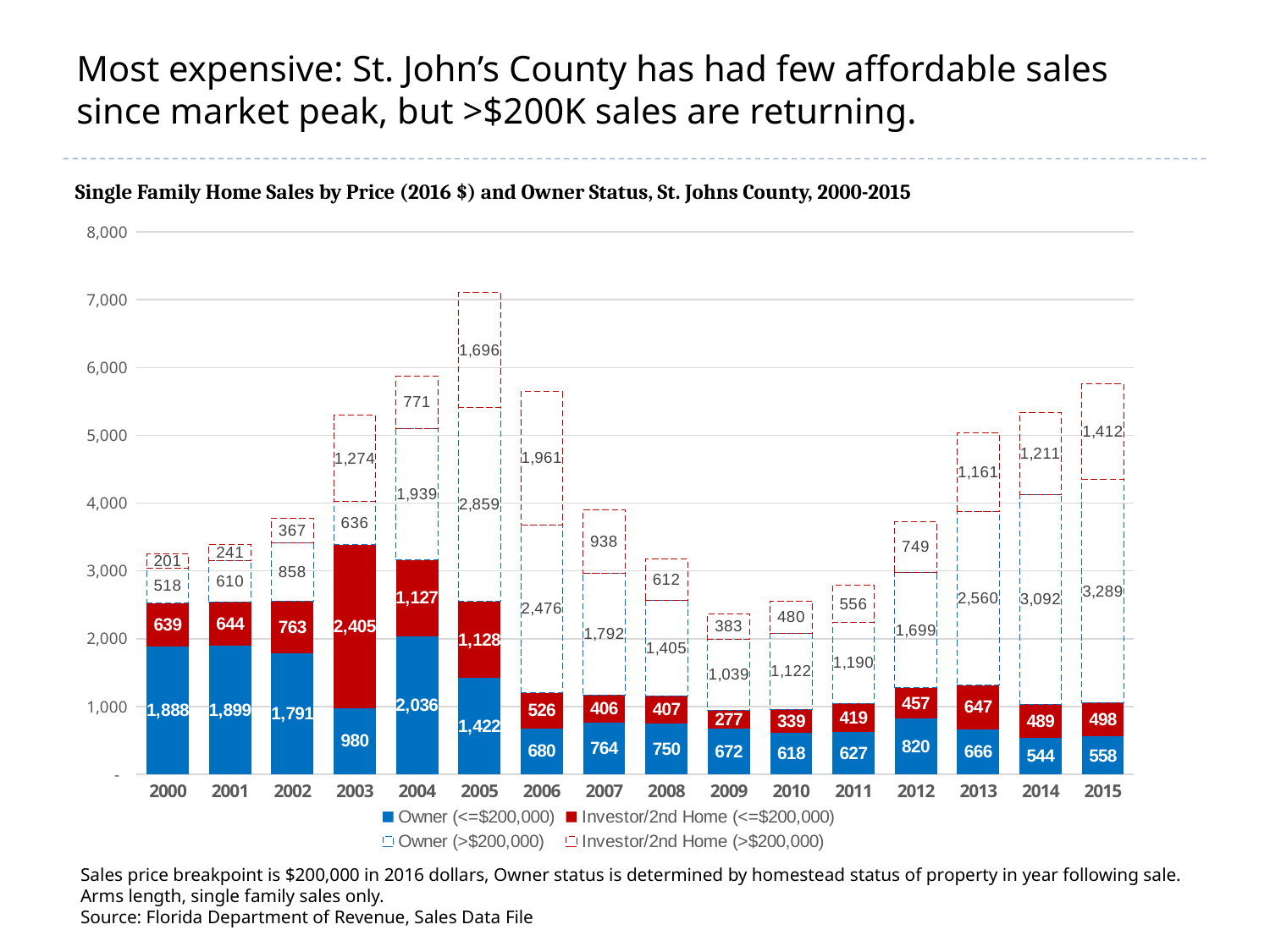
What is the total of the stacked bar for 2005? 7,105 Is the total of the stacked bar for 2009 greater or less than 3,000? less How many years are shown on the x axis? 16 How many series does the legend list? 4 What is the value for Owner (<=$200,000) in 2004? 2,036 What is the value for Investor/2nd Home (<=$200,000) in 2003? 2,405 What is the difference between the Owner (<=$200,000) values in 2004 and 2003? 1,056 What type of chart is shown on the slide? Stacked bar chart What is the value for Owner (>$200,000) in 2015? 3,289 Which year has the highest value for Owner (<=$200,000)? 2004 Which year has the lowest value for Owner (<=$200,000)? 2014 What is the value for Investor/2nd Home (>$200,000) in 2006? 1,961